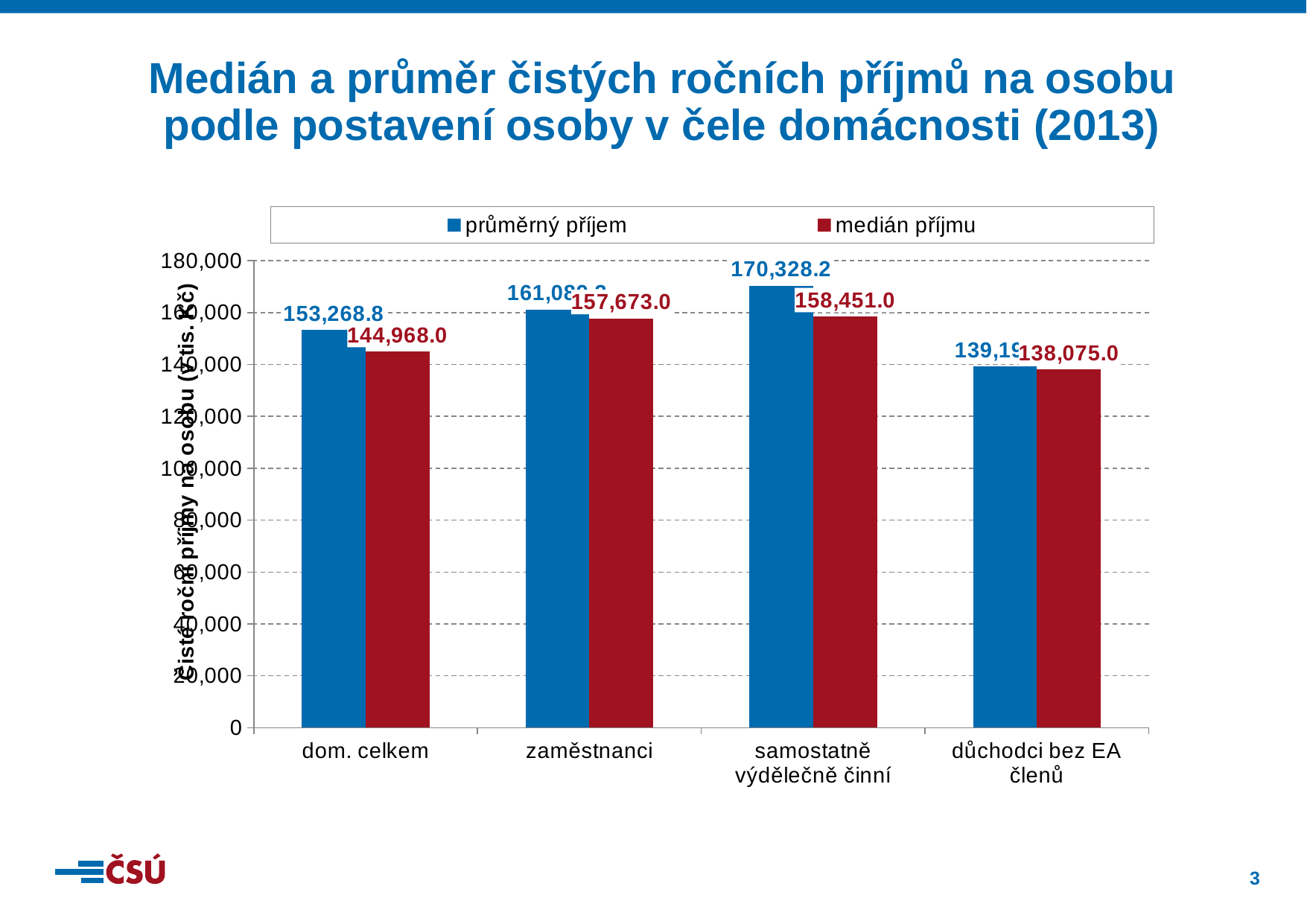
Which category has the lowest medián příjmu? důchodci bez EA členů Which category has the highest průměrný příjem? samostatně výdělečně činní What is the medián příjmu value for zaměstnanci? 157,673.0 How many categories are shown on the x axis? 4 What is the difference between průměrný příjem and medián příjmu for samostatně výdělečně činní? 11,877.2 What is the průměrný příjem value for dom. celkem? 153,268.8 Is the průměrný příjem value for důchodci bez EA členů greater or less than 120,000? greater What is the difference between the medián příjmu for zaměstnanci and for důchodci bez EA členů? 19,598.0 Which is larger for dom. celkem: průměrný příjem or medián příjmu? průměrný příjem What is the medián příjmu value for samostatně výdělečně činní? 158,451.0 How many series does the legend list? 2 What is the medián příjmu value for důchodci bez EA členů? 138,075.0